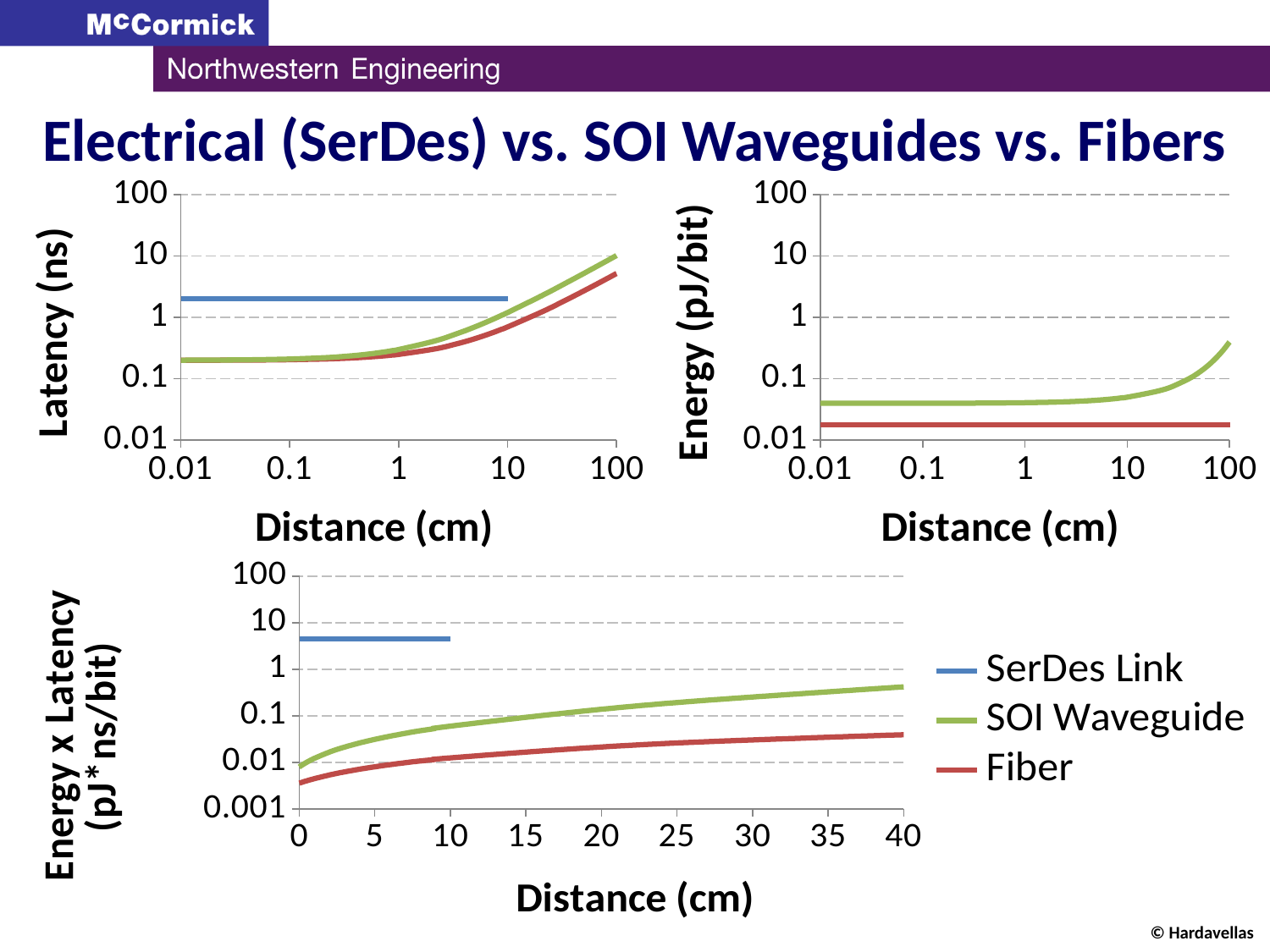
In the bottom Energy x Latency chart, is the SerDes Link value greater or less than 1 pJ*ns/bit? greater In the top-right Energy chart, does the Fiber line rise, fall, or stay flat as distance increases? stay flat In the top-right Energy chart, at 100 cm, which series has the higher energy: SOI Waveguide or Fiber? SOI Waveguide How many series does the legend list for the charts on this slide? 3 What are the three series named in the legend? SerDes Link, SOI Waveguide, Fiber In the top-left Latency chart, at 100 cm, which has the higher latency: SOI Waveguide or Fiber? SOI Waveguide In the top-left Latency chart, is the latency of the SerDes Link greater or less than 1 ns? greater What kind of chart is the top-left chart (Latency vs. Distance)? line chart In the bottom Energy x Latency chart, at 5 cm, which is higher: SerDes Link or Fiber? SerDes Link In the top-left Latency chart, is the Fiber latency at 0.01 cm greater or less than 1 ns? less In the bottom Energy x Latency chart, does the SOI Waveguide line rise or fall as distance increases from 0 to 40 cm? rise